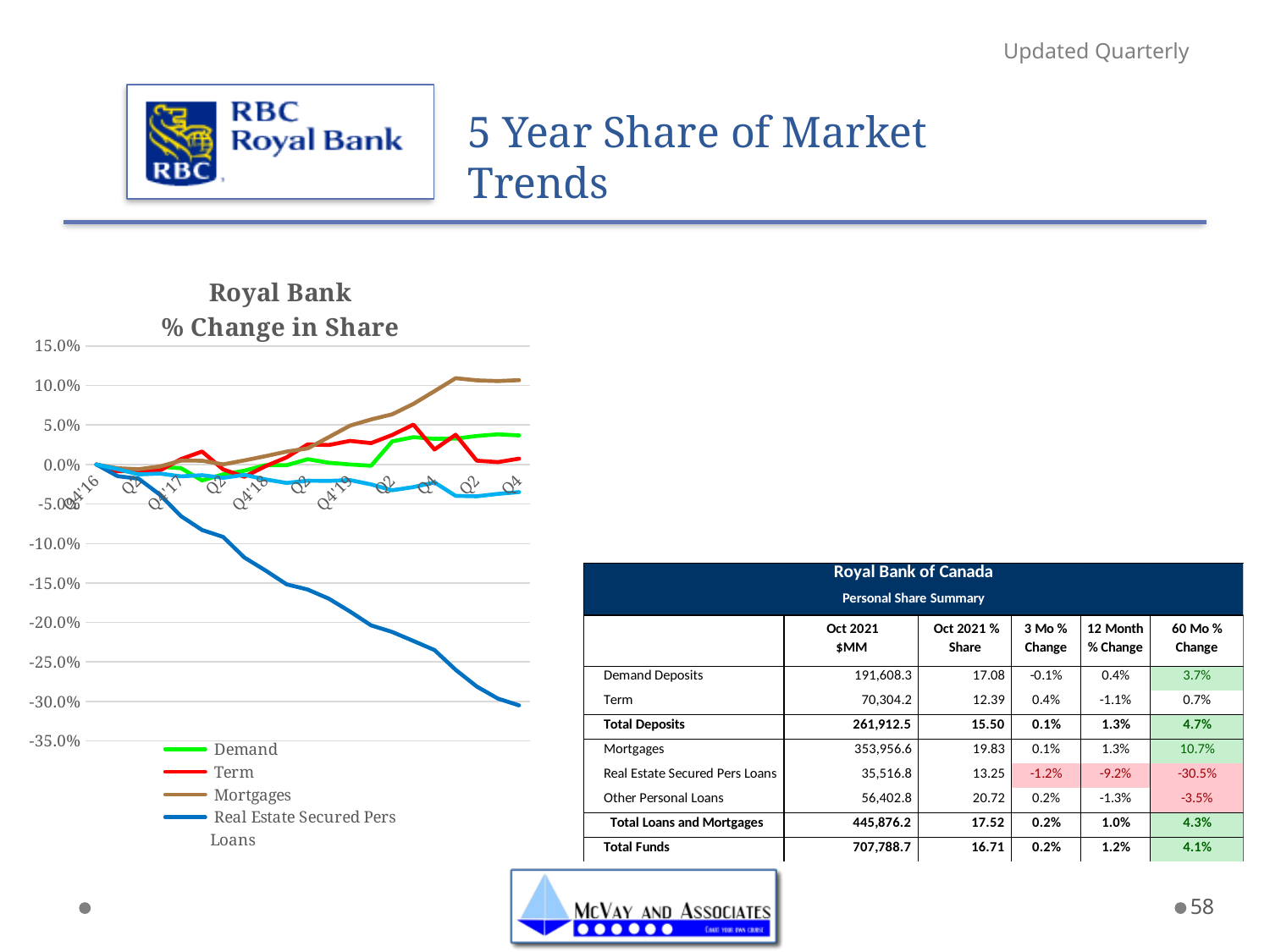
How many series does the legend of the "Royal Bank % Change in Share" chart list? 4 In the "Royal Bank % Change in Share" chart, is the final value for Real Estate Secured Pers Loans greater or less than -25.0%? less What kind of chart is the "Royal Bank % Change in Share" chart? line chart In the "Royal Bank % Change in Share" chart, is the value for Real Estate Secured Pers Loans at Q4'17 greater or less than -5.0%? less In the "Royal Bank % Change in Share" chart, which series has the lowest value at the end of the period? Real Estate Secured Pers Loans In the "Royal Bank % Change in Share" chart, is the final value for Mortgages greater or less than 5.0%? greater In the "Royal Bank % Change in Share" chart, does the Real Estate Secured Pers Loans line rise or fall over the period? fall In the "Royal Bank % Change in Share" chart, which series has the highest value at the end of the period? Mortgages Which series in the "Royal Bank % Change in Share" chart is drawn in brown? Mortgages Which series in the "Royal Bank % Change in Share" chart is drawn in blue? Real Estate Secured Pers Loans In the "Royal Bank % Change in Share" chart, which is larger at the end of the period: Mortgages or Demand? Mortgages In the "Royal Bank % Change in Share" chart, does the Mortgages line rise or fall over the period? rise